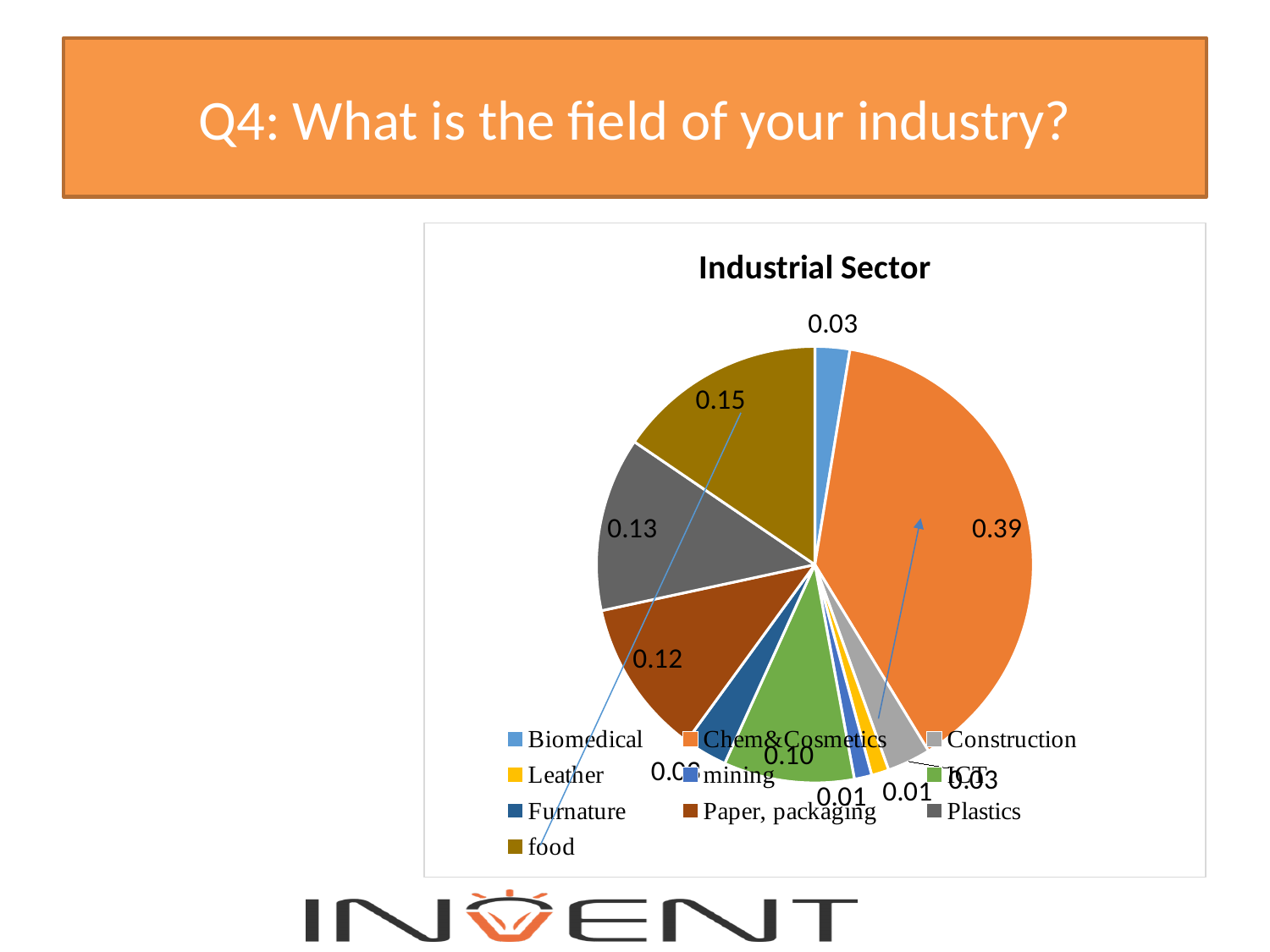
What is the value shown for Plastics? 0.13 What is the value shown for Biomedical? 0.03 What is the value shown for ICT? 0.10 What is the value shown for Paper, packaging? 0.12 Which sector has the largest slice of the pie? Chem&Cosmetics What is the title of the chart? Industrial Sector What is the value shown for Chem&Cosmetics? 0.39 What is the value shown for food? 0.15 Which is larger, the value for food or the value for Plastics? food What kind of chart is shown on the slide? pie chart What is the difference between the value for Chem&Cosmetics and the value for food? 0.24 How many categories does the legend of the pie chart list? 10